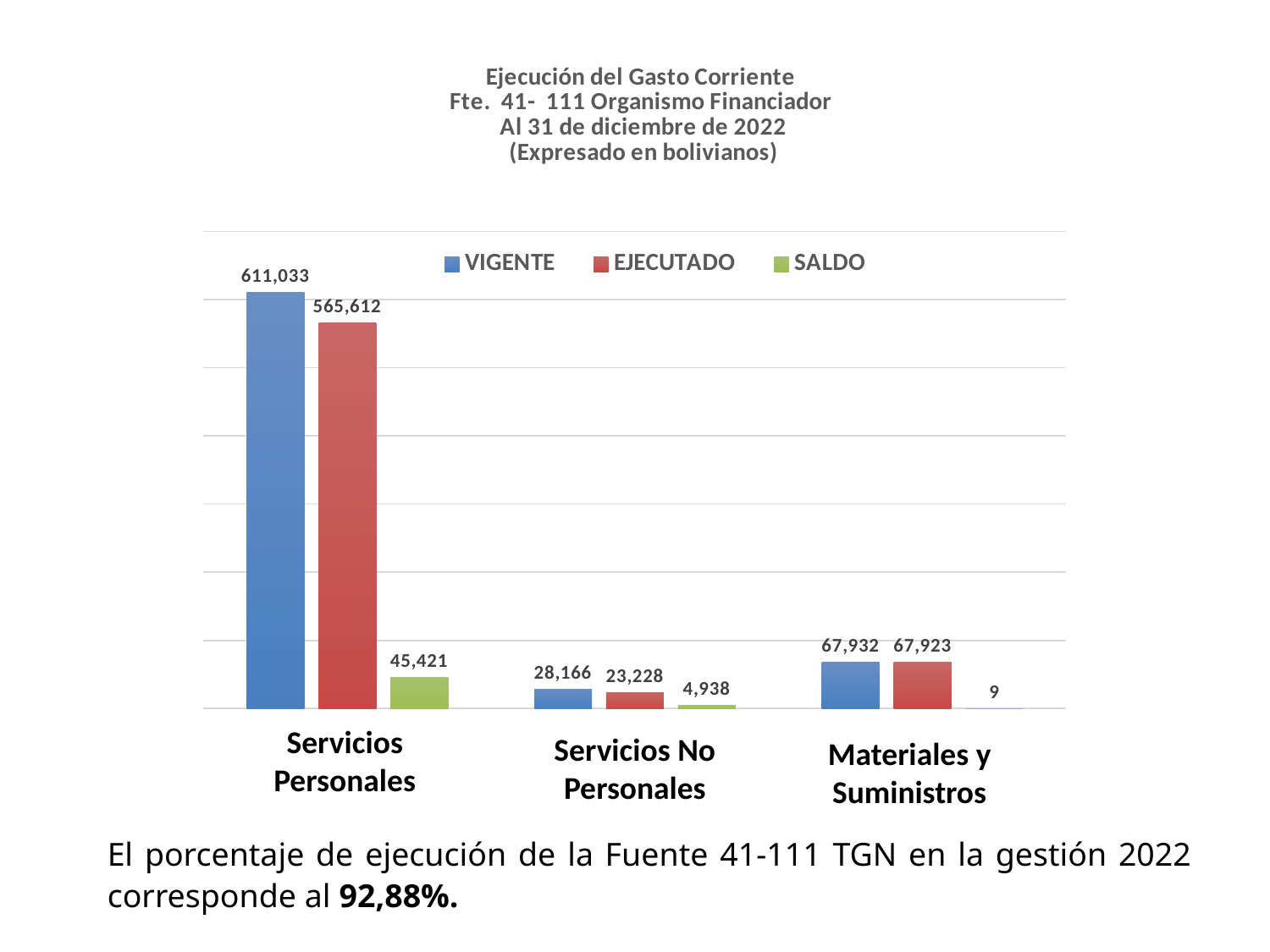
What is the VIGENTE value for Servicios Personales? 611,033 What is the SALDO value for Materiales y Suministros? 9 What is the EJECUTADO value for Materiales y Suministros? 67,923 What is the EJECUTADO value for Servicios No Personales? 23,228 How many series does the legend list? 3 Which category has the lowest SALDO value? Materiales y Suministros What kind of chart is shown on the slide? Bar chart What is the difference between VIGENTE and EJECUTADO for Servicios Personales? 45,421 Which is larger, the SALDO for Servicios Personales or the SALDO for Servicios No Personales? Servicios Personales Which category has the highest VIGENTE value? Servicios Personales How many categories are shown on the x axis? 3 Which colour represents the SALDO series in the legend? Green